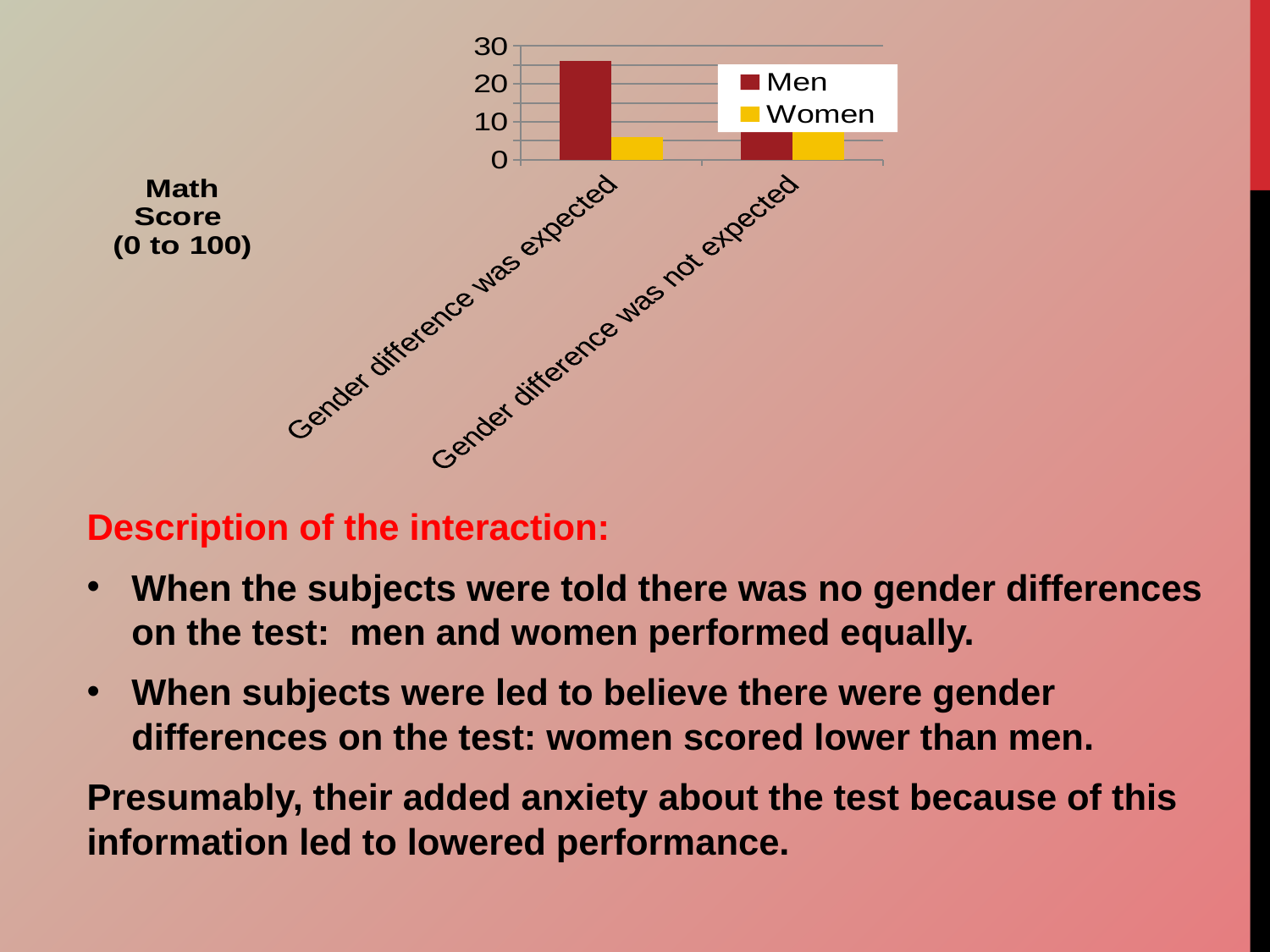
How many series does the chart's legend list? 2 Is the value for Women in the 'Gender difference was expected' category greater or less than 10? less Which series has the highest bar in the chart, and in which category? Men, Gender difference was expected Is the value for Women in the 'Gender difference was expected' category greater or less than 20? less In the 'Gender difference was expected' category, which series has the larger value, Men or Women? Men What kind of chart is shown on the slide? bar chart How many categories are shown on the x axis of the chart? 2 Is the value for Men in the 'Gender difference was expected' category greater or less than 20? greater What is the label given for the vertical axis of the chart? Math Score (0 to 100) What colour represents the Men series in the chart? dark red